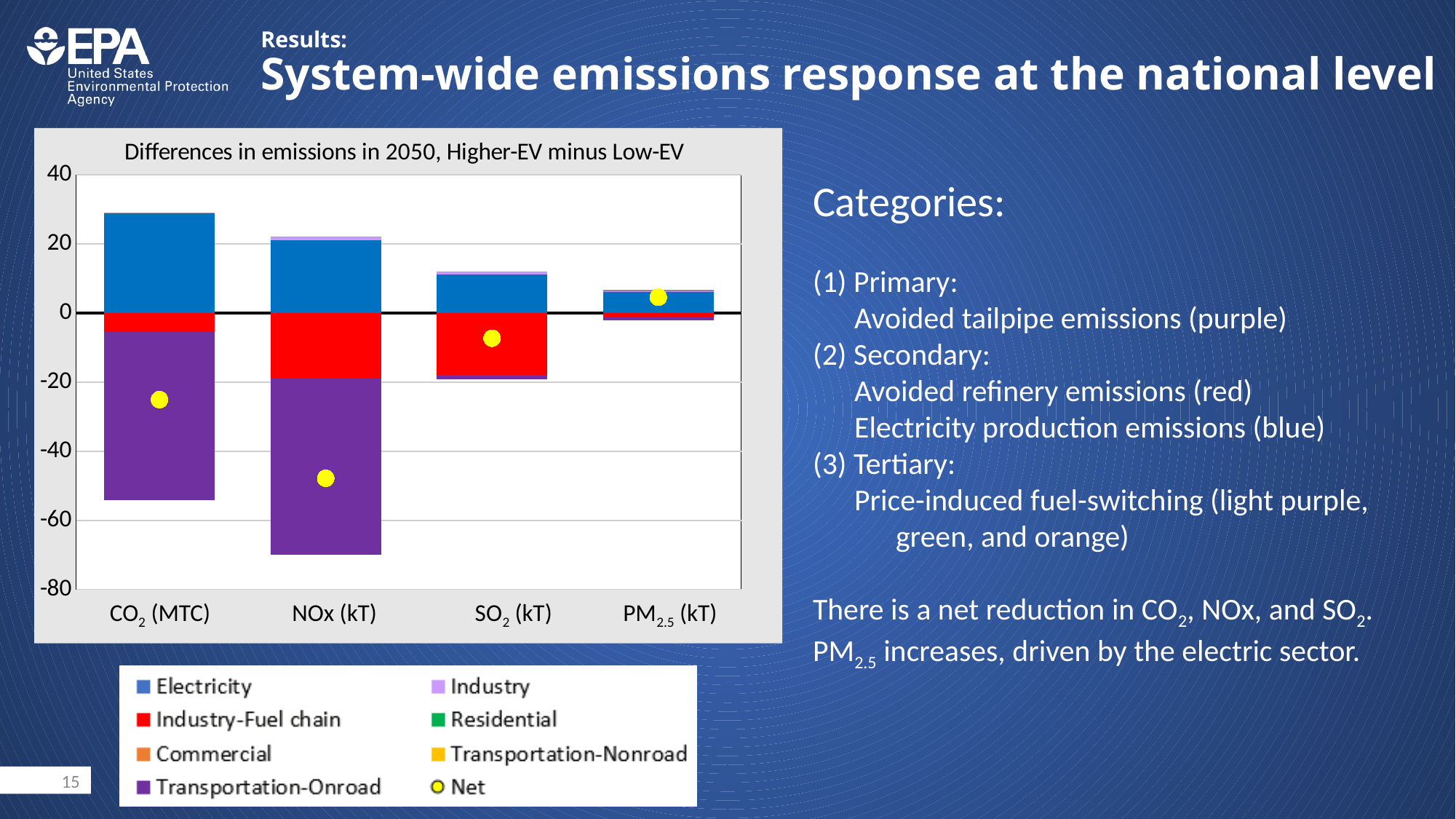
Which category has the highest Net value? PM2.5 (kT) Which colour represents Transportation-Onroad in the chart legend? Purple Is the Net value for CO2 (MTC) greater or less than -20? less How many entries does the chart legend list? 8 Is the Electricity value for CO2 (MTC) greater or less than 20? greater What kind of chart is shown on the slide? Stacked bar chart Which has the larger Net value, CO2 (MTC) or NOx (kT)? CO2 (MTC) Which category has the lowest Net value? NOx (kT) Is the Net value for NOx (kT) greater or less than -40? less What is the title of the chart? Differences in emissions in 2050, Higher-EV minus Low-EV How many pollutant categories are shown on the x axis of the chart? 4